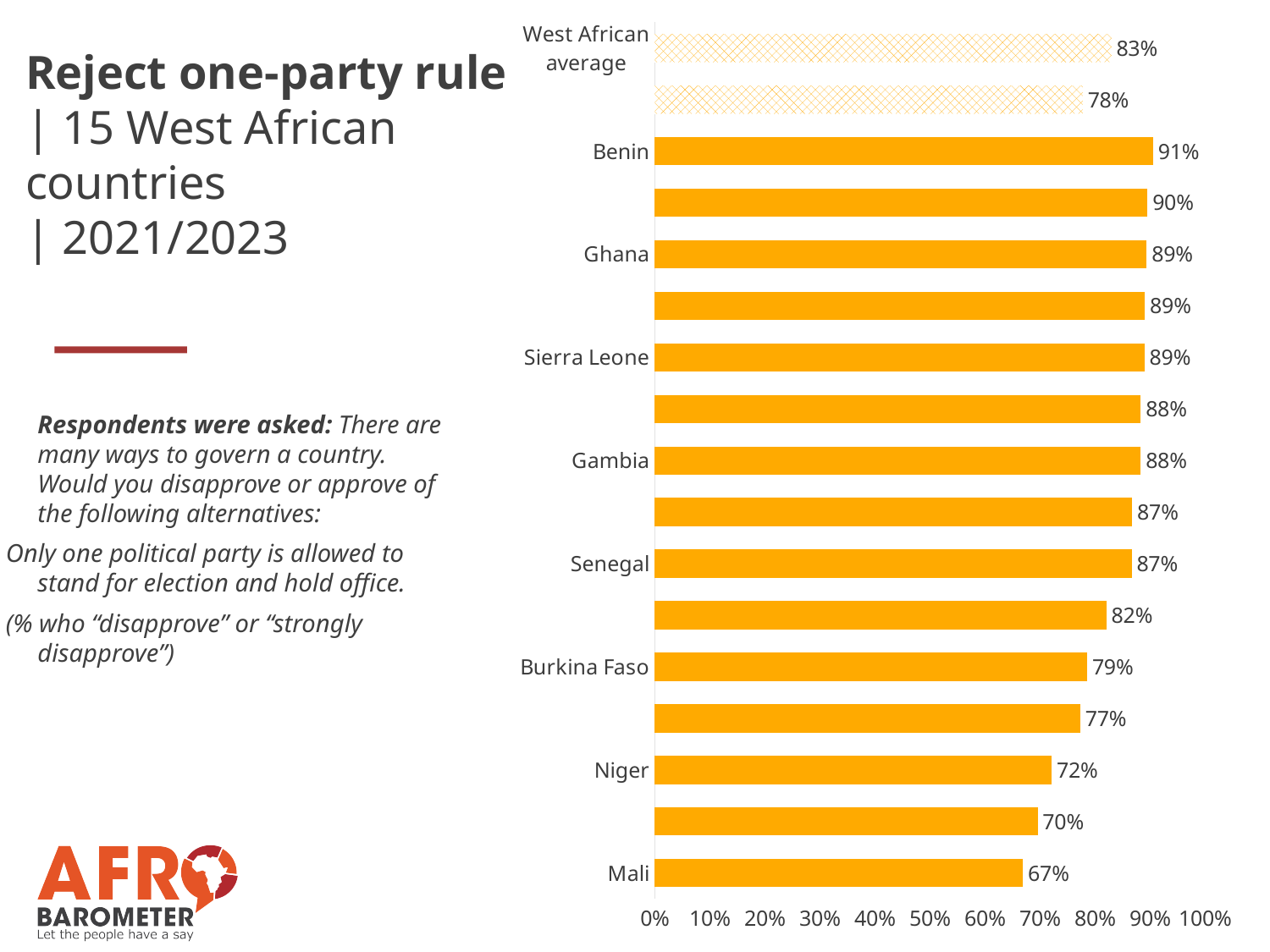
What is the value for Niger? 72% What is the value for Senegal? 87% What is the difference between the values for Benin and Mali? 24 percentage points What is the value for Burkina Faso? 79% What is the value for Benin? 91% What is the value for Mali? 67% What is the value for Gambia? 88% What is the value for Sierra Leone? 89% Which has a larger value, Niger or Burkina Faso? Burkina Faso Which country has the highest value? Benin Which country has the lowest value? Mali What is the value for Ghana? 89%